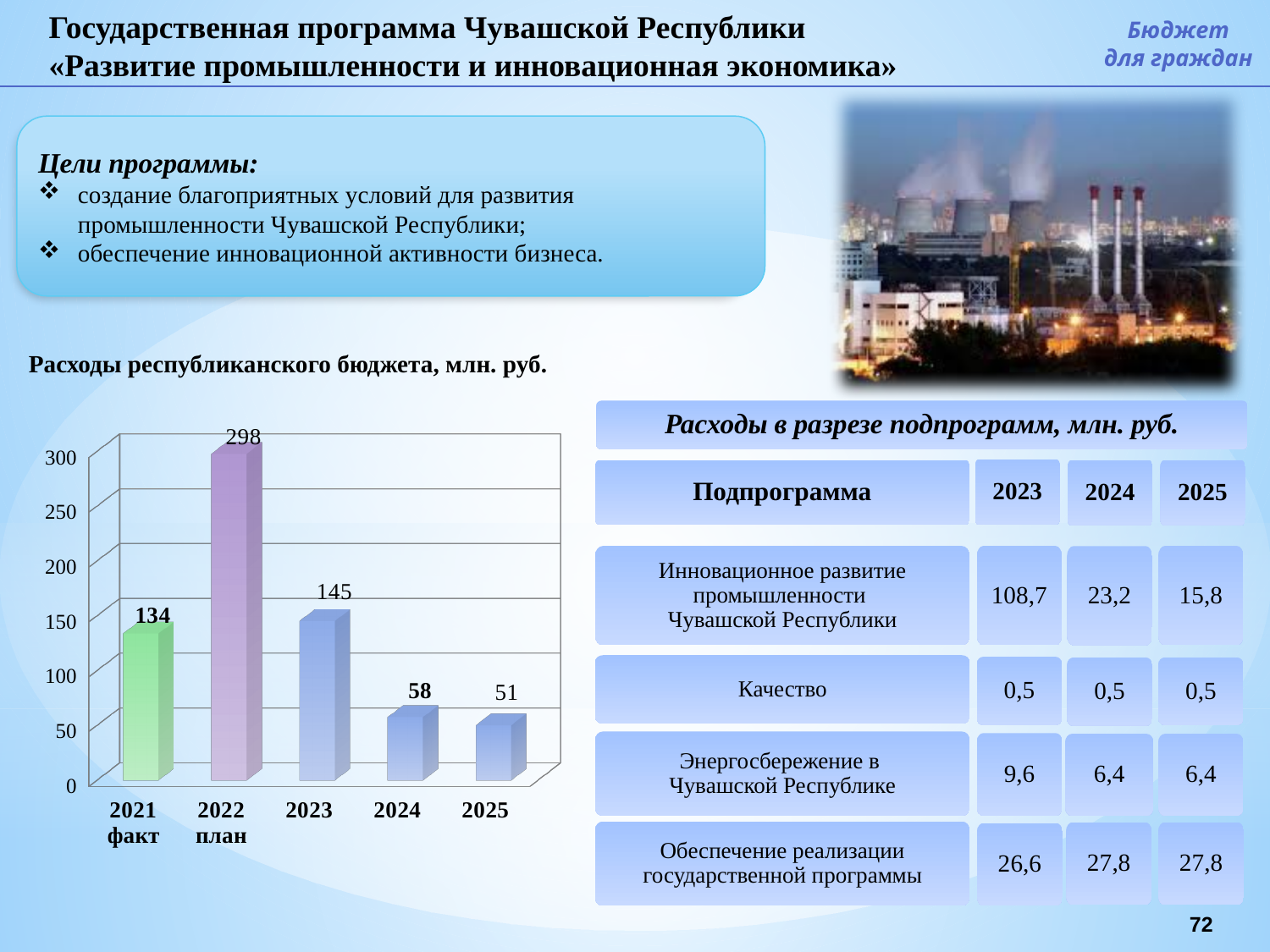
What is the difference between the 2024 and 2025 values in the chart 'Расходы республиканского бюджета, млн. руб.'? 7 Which year has the highest value in the chart 'Расходы республиканского бюджета, млн. руб.'? 2022 What is the value for 2023 in the chart 'Расходы республиканского бюджета, млн. руб.'? 145 What is the value for 2025 in the chart 'Расходы республиканского бюджета, млн. руб.'? 51 In the chart 'Расходы республиканского бюджета, млн. руб.', which is larger: the value for 2021 or the value for 2023? 2023 Which year has the lowest value in the chart 'Расходы республиканского бюджета, млн. руб.'? 2025 How many years (bars) are shown in the chart 'Расходы республиканского бюджета, млн. руб.'? 5 What is the value for 2021 (факт) in the chart 'Расходы республиканского бюджета, млн. руб.'? 134 What is the difference between the 2022 and 2023 values in the chart 'Расходы республиканского бюджета, млн. руб.'? 153 In the chart 'Расходы республиканского бюджета, млн. руб.', do the values rise or fall from 2022 to 2025? fall What is the value for 2022 (план) in the chart 'Расходы республиканского бюджета, млн. руб.'? 298 What kind of chart is 'Расходы республиканского бюджета, млн. руб.'? bar chart